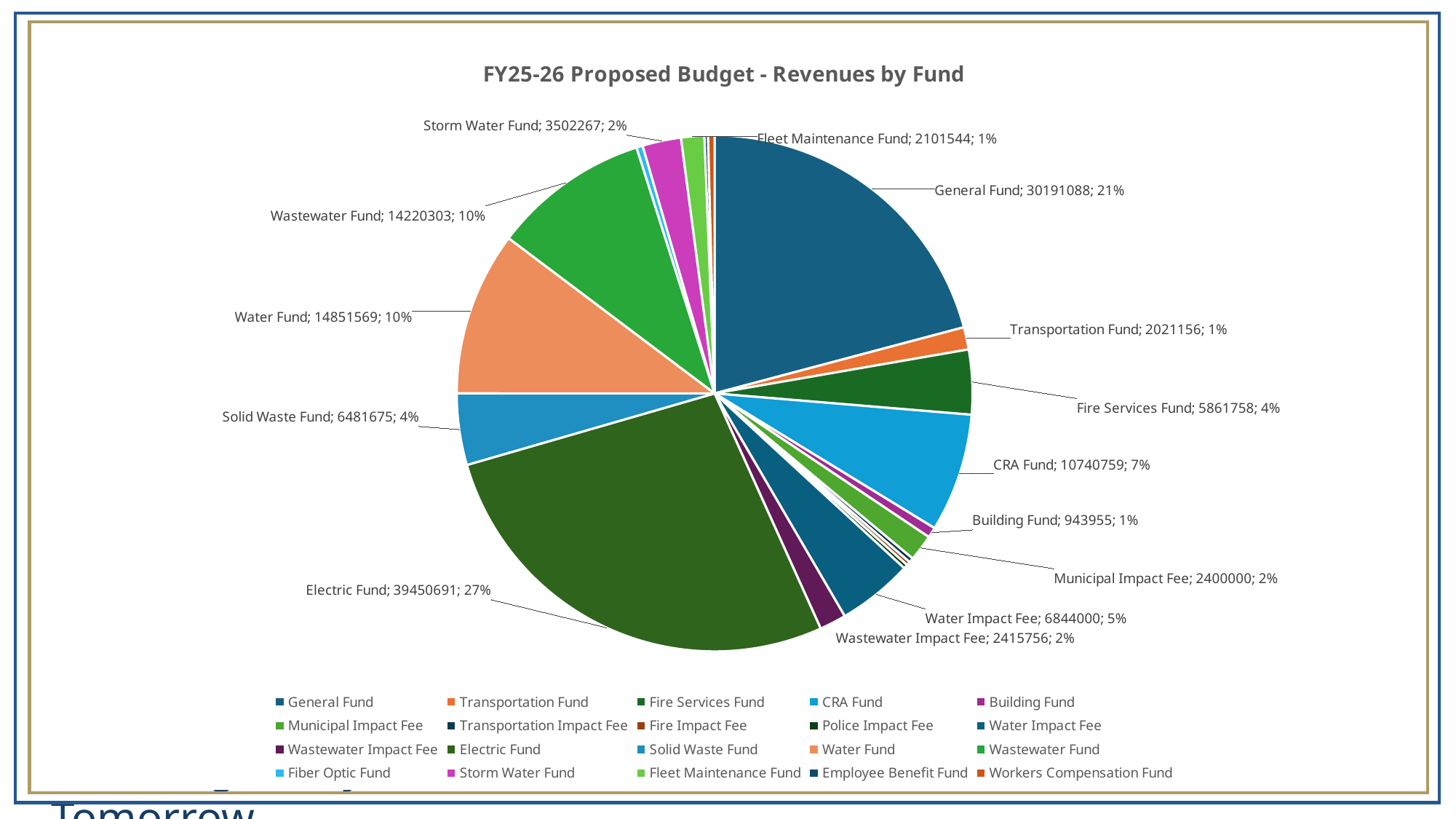
What type of chart is shown on the slide? pie chart What percentage share of the pie does the Electric Fund represent? 27% What is the revenue value shown for the CRA Fund? 10740759 How many funds are listed in the legend? 20 What is the title of the chart? FY25-26 Proposed Budget - Revenues by Fund What percentage share of the pie does the Wastewater Fund represent? 10% What is the revenue value shown for the Water Impact Fee? 6844000 Which is larger, the Fire Services Fund or the Solid Waste Fund? Solid Waste Fund What is the difference between the Water Fund value and the Wastewater Fund value? 631266 What is the revenue value shown for the Storm Water Fund? 3502267 What is the revenue value shown for the General Fund? 30191088 Which fund has the largest share of the pie? Electric Fund